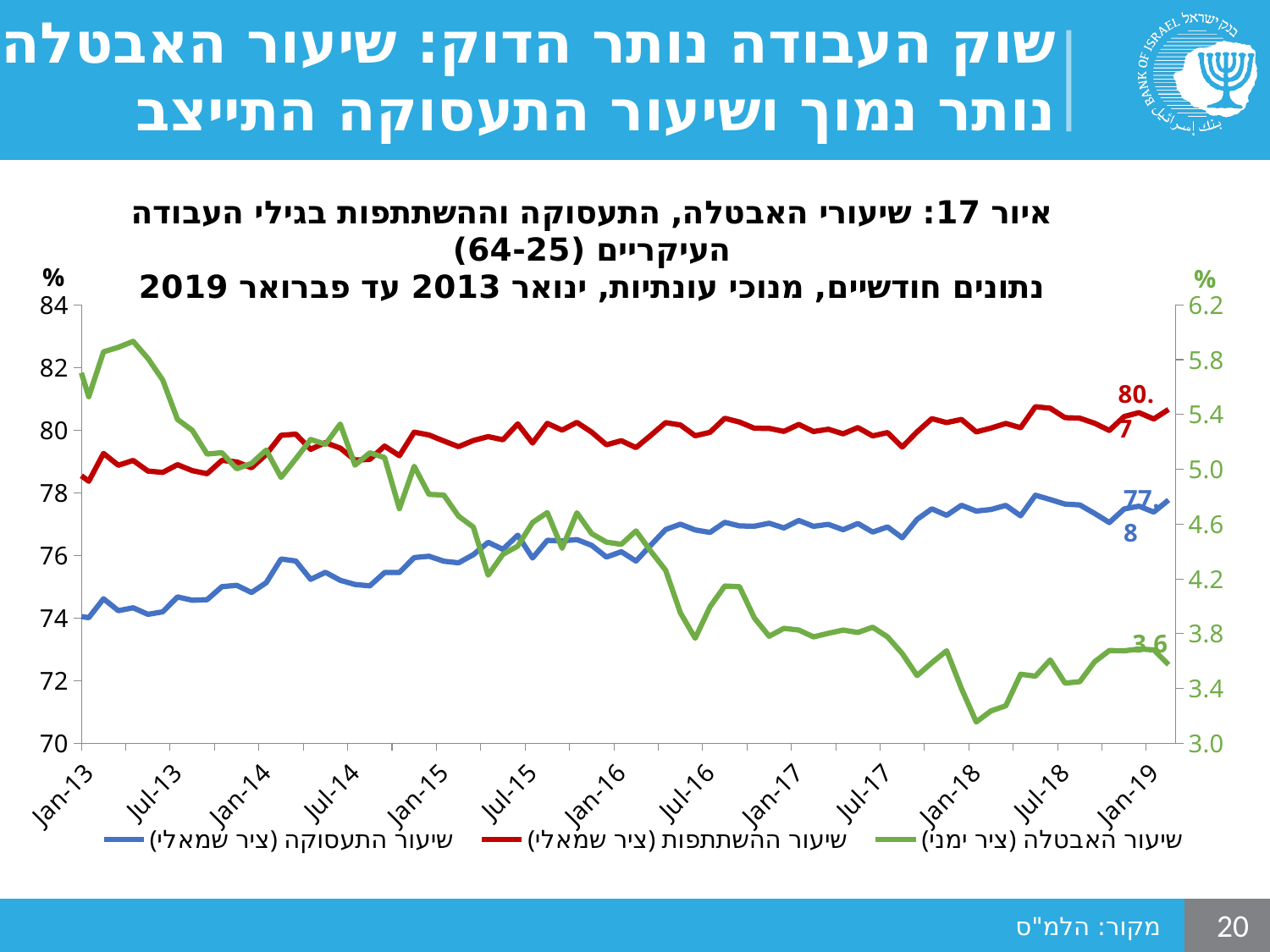
What kind of chart is shown on the slide? line chart Is the unemployment rate (green line, right axis) at Jan-13 greater or less than 5.0? greater What is the latest labelled value of the employment rate series (שיעור התעסוקה, blue line)? 77.8 Does the unemployment rate (green line, right axis) rise or fall overall from Jan-13 to Jan-19? fall How many series does the legend list? 3 Does the employment rate (blue line, left axis) rise or fall overall from Jan-13 to Jan-19? rise What is the difference between the latest labelled participation rate (80.7) and the latest labelled employment rate (77.8)? 2.9 Which series is plotted on the right axis (ציר ימני) according to the legend? שיעור האבטלה At the end of the series, which is larger: the participation rate (red line) or the employment rate (blue line)? participation rate (red line) What is the latest labelled value of the unemployment rate series (שיעור האבטלה, green line)? 3.6 Is the employment rate (blue line, left axis) at Jan-13 greater or less than 76? less What is the latest labelled value of the participation rate series (שיעור ההשתתפות, red line)? 80.7